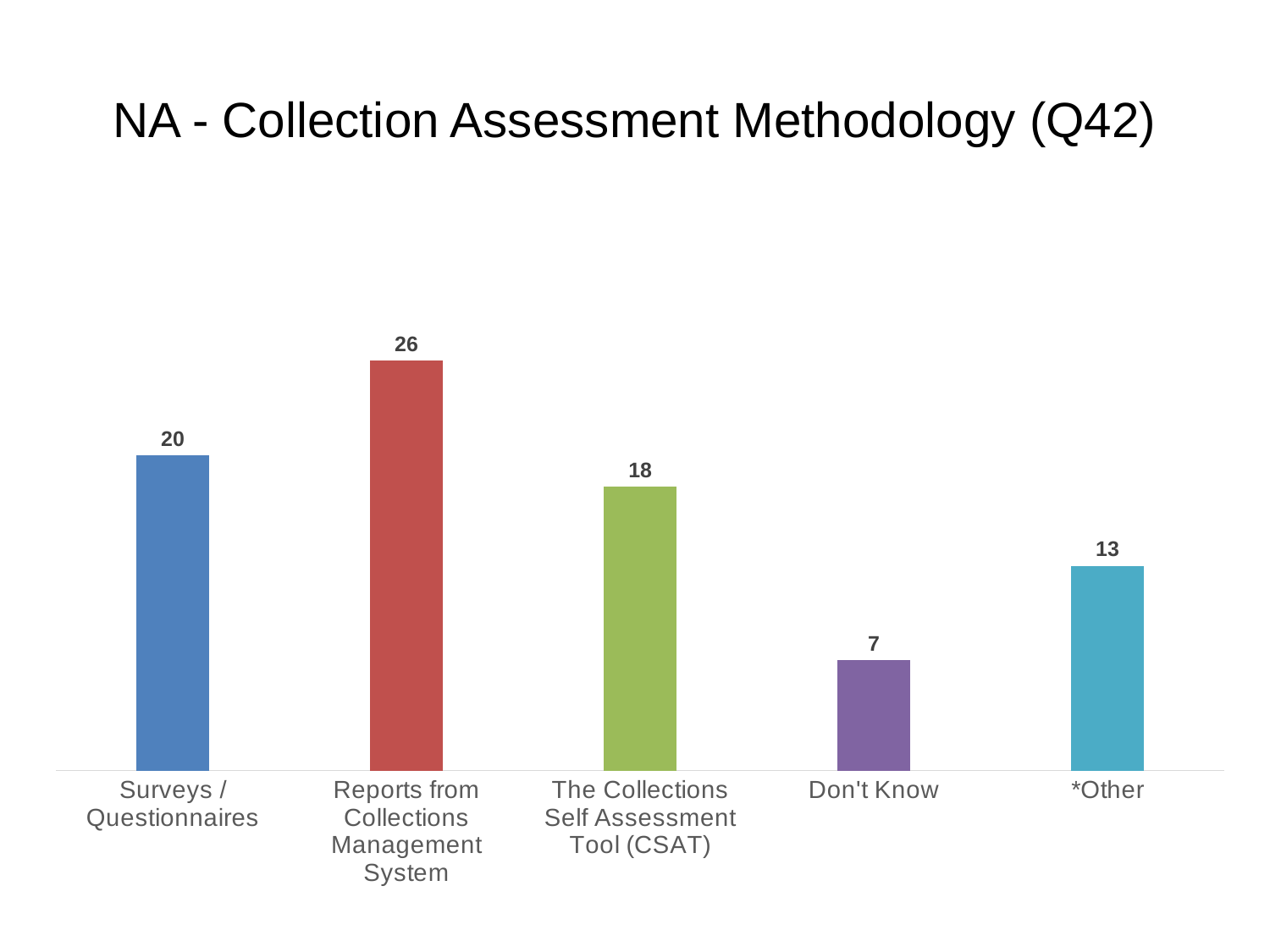
What is the title of the slide? NA - Collection Assessment Methodology (Q42) What is the value for *Other? 13 Which is larger, the value for The Collections Self Assessment Tool (CSAT) or the value for *Other? The Collections Self Assessment Tool (CSAT) What is the value for Surveys / Questionnaires? 20 What is the difference between the values for Reports from Collections Management System and Surveys / Questionnaires? 6 What is the value for Reports from Collections Management System? 26 What kind of chart is shown on the slide? Bar chart Which category has the lowest value? Don't Know What is the value for The Collections Self Assessment Tool (CSAT)? 18 Which category has the highest value? Reports from Collections Management System How many categories are shown in the chart? 5 What is the value for Don't Know? 7